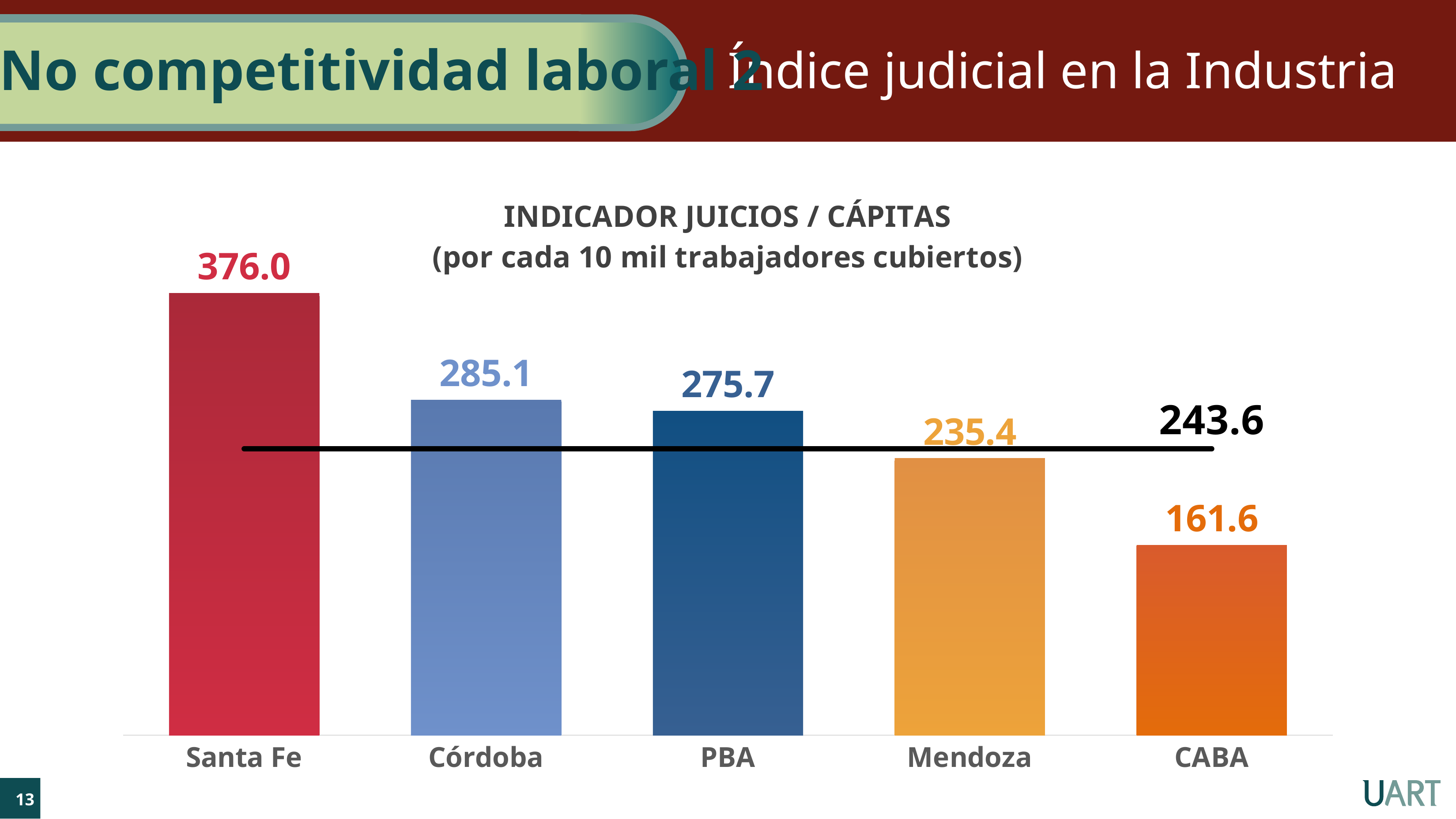
How many categories are shown in the chart? 5 What value is labelled on the horizontal reference line across the chart? 243.6 What is the value for CABA? 161.6 What is the value for Santa Fe? 376.0 What is the value for PBA? 275.7 What is the difference between the values for Santa Fe and CABA? 214.4 Which category has the highest value? Santa Fe What is the value for Mendoza? 235.4 What is the value for Córdoba? 285.1 Which is larger, the value for Córdoba or the value for Mendoza? Córdoba Which category has the lowest value? CABA What kind of chart is shown on the slide? Bar chart